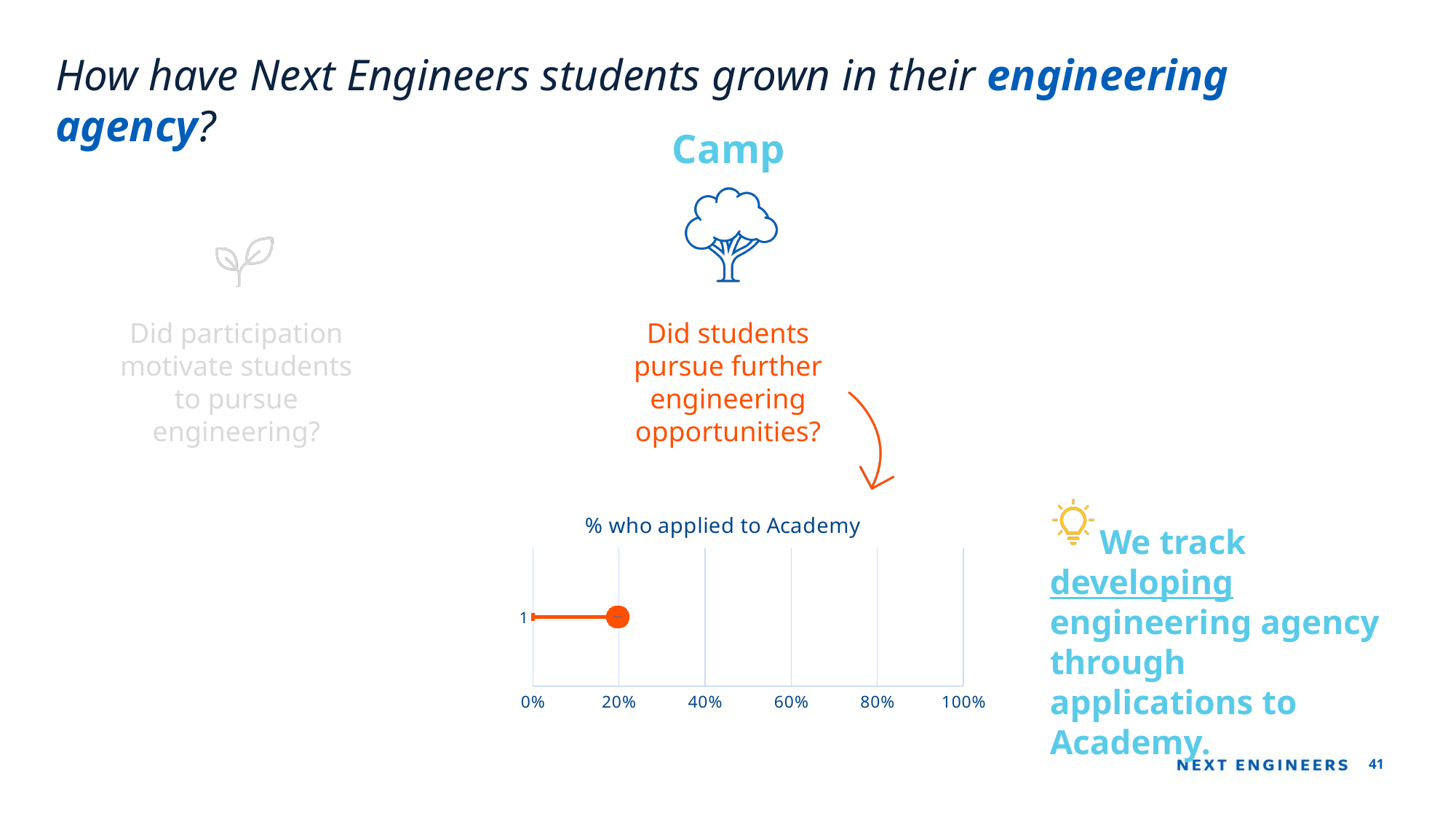
What is the title of the chart on the slide? % who applied to Academy In the "% who applied to Academy" chart, is the value for category 1 greater or less than 60%? less What kind of chart is shown under "% who applied to Academy"? bar chart How many categories are plotted in the "% who applied to Academy" chart? 1 In the "% who applied to Academy" chart, is the value for category 1 greater or less than 40%? less What is the highest value shown on the x axis of the "% who applied to Academy" chart? 100% What is the label of the single category on the y axis of the "% who applied to Academy" chart? 1 In the "% who applied to Academy" chart, which axis tick does the plotted point for category 1 land on? 20%